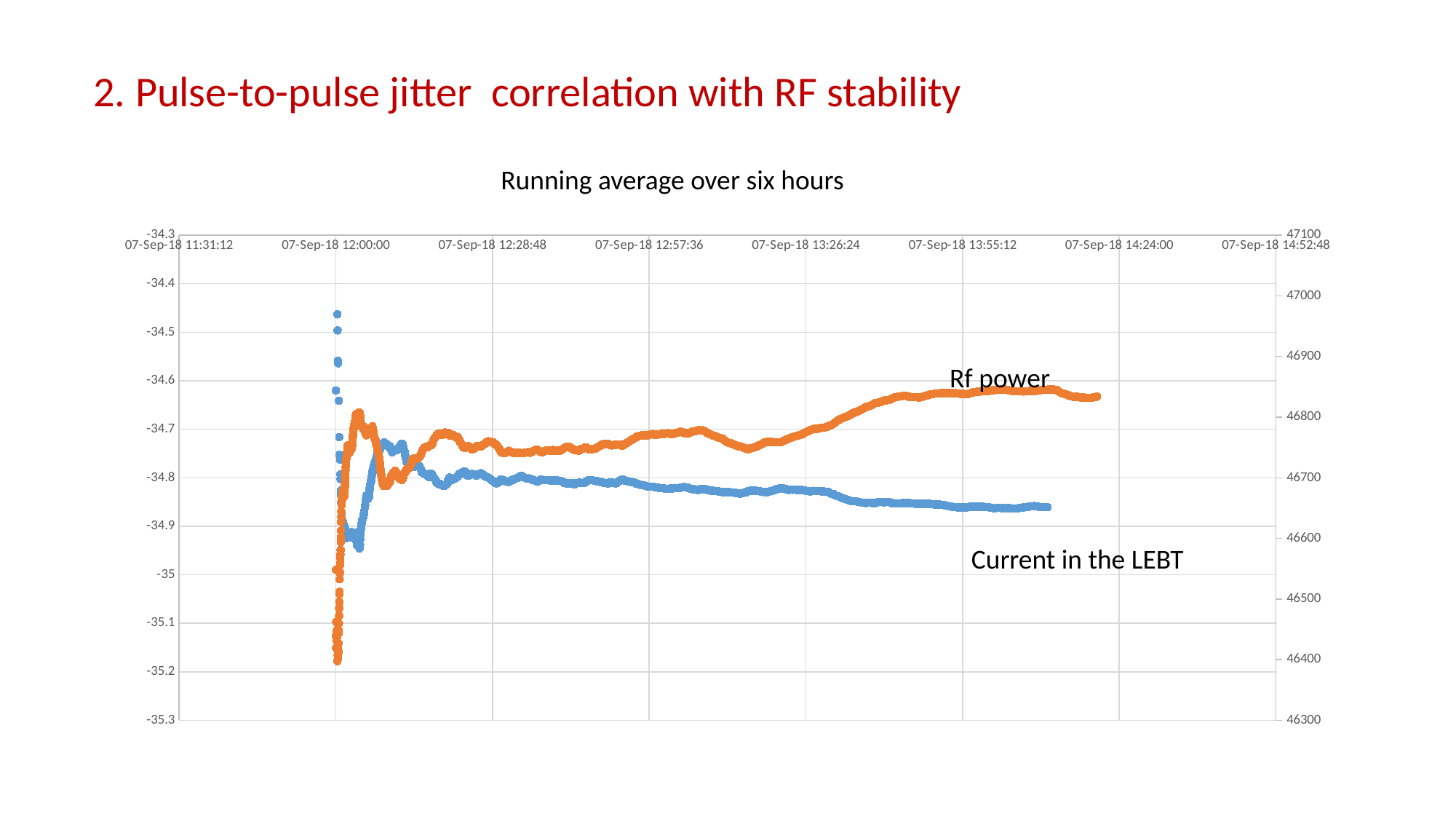
What colour is the Rf power series? orange Does the Rf power series rise or fall between 07-Sep-18 12:57:36 and 07-Sep-18 14:24:00? rise How many data series are plotted on the chart? 2 Does the Current in the LEBT series rise or fall between 07-Sep-18 12:28:48 and 07-Sep-18 14:24:00? fall What is the lowest value shown on the right-hand vertical axis? 46300 Which series is plotted higher on the chart near 07-Sep-18 14:24:00, Rf power or Current in the LEBT? Rf power What kind of chart is shown on the slide? scatter chart What is the title of the chart? Running average over six hours